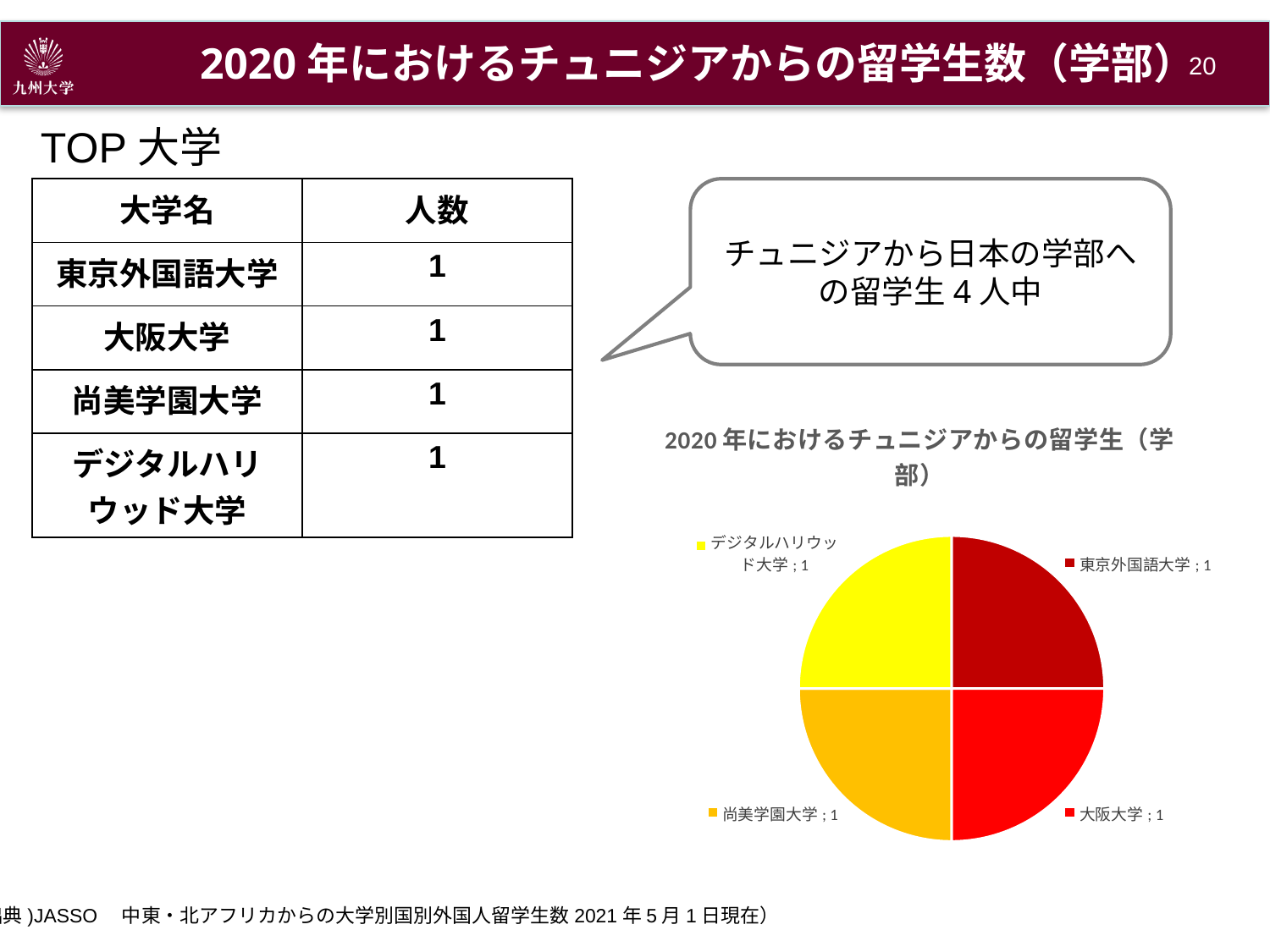
What is the difference between the values for 東京外国語大学 and 尚美学園大学 in the pie chart? 0 How many slices does the pie chart have? 4 What is the total of all the values in the pie chart? 4 What is the value shown for 東京外国語大学 in the pie chart? 1 What is the value shown for 大阪大学 in the pie chart? 1 What share of the pie does 大阪大学 represent? 25% Which university's slice is coloured yellow in the pie chart? デジタルハリウッド大学 What is the value shown for デジタルハリウッド大学 in the pie chart? 1 What is the value shown for 尚美学園大学 in the pie chart? 1 What is the title of the pie chart? 2020年におけるチュニジアからの留学生（学部） What kind of chart is shown on the slide? pie chart What share of the pie does デジタルハリウッド大学 represent? 25%